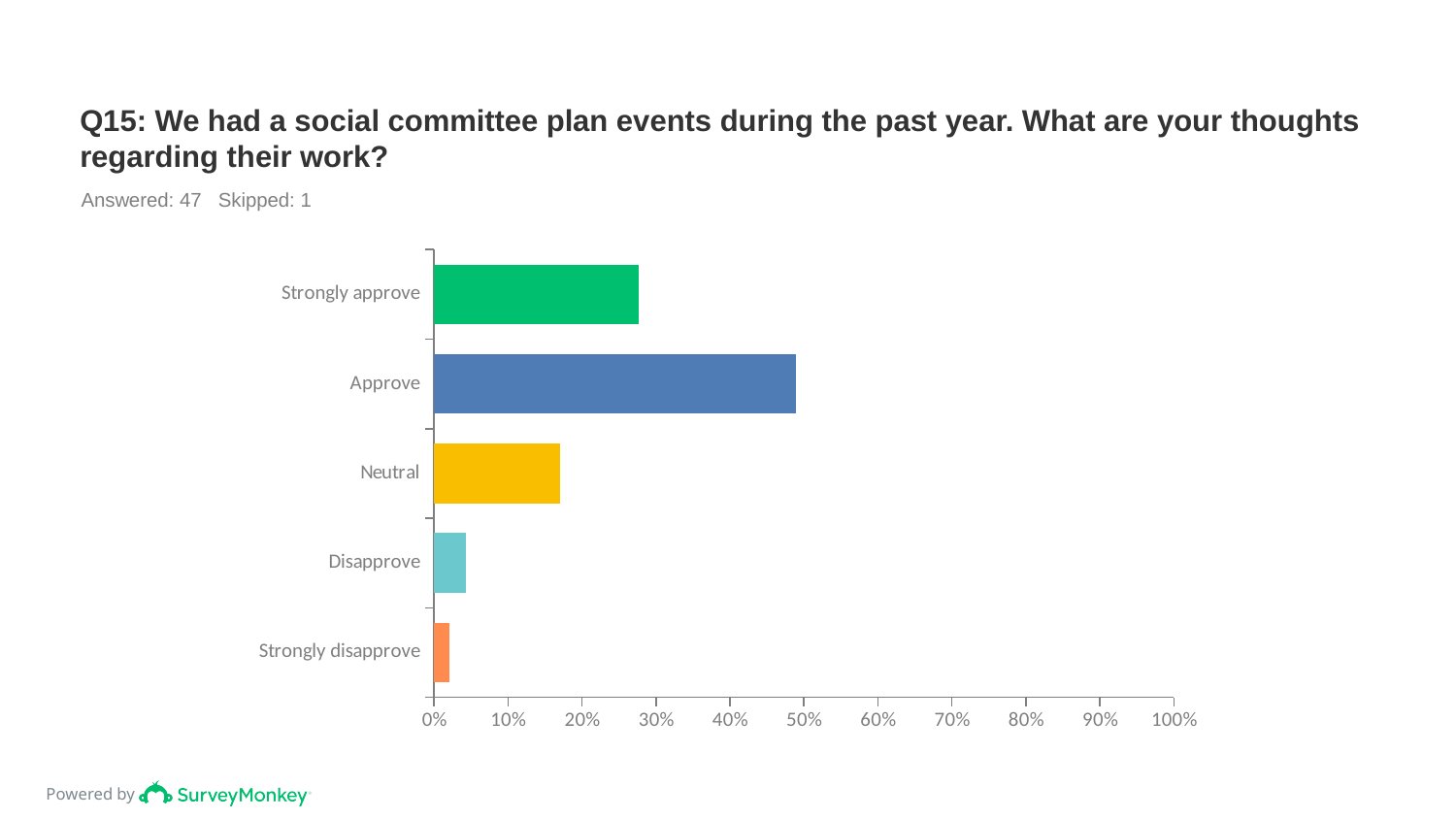
Which is larger, the value for Strongly approve or the value for Neutral? Strongly approve Is the value for Disapprove greater or less than 10%? less Which is larger, the value for Disapprove or the value for Strongly disapprove? Disapprove How many categories are plotted in the chart? 5 Is the value for Neutral greater or less than 10%? greater Which category has the lowest value? Strongly disapprove Which category has the highest value? Approve Is the value for Strongly approve greater or less than 30%? less What is the maximum value shown on the horizontal axis? 100% How many respondents answered this question according to the slide? 47 What kind of chart is shown on the slide? bar chart